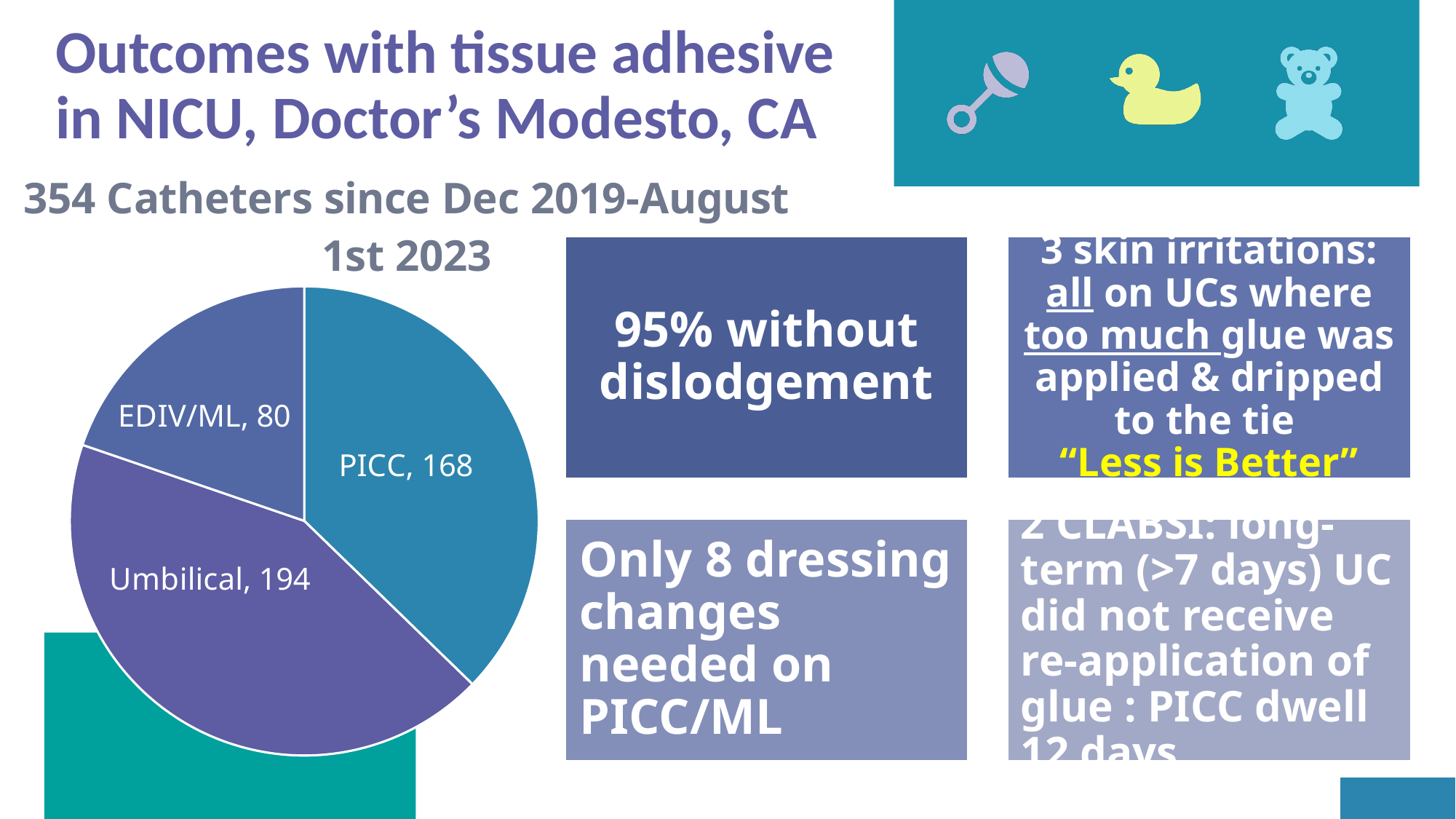
How many categories are shown in the pie chart? 3 What is the difference between the Umbilical and PICC values in the pie chart? 26 What is the value for EDIV/ML in the pie chart? 80 What is the difference between the PICC and EDIV/ML values in the pie chart? 88 Which category has the largest slice in the pie chart? Umbilical What kind of chart is shown on the slide? Pie chart What is the title of the pie chart? 354 Catheters since Dec 2019-August 1st 2023 Which is larger in the pie chart, PICC or EDIV/ML? PICC Which category has the smallest slice in the pie chart? EDIV/ML What is the value for Umbilical in the pie chart? 194 What is the sum of the three values labelled in the pie chart? 442 What is the value for PICC in the pie chart? 168